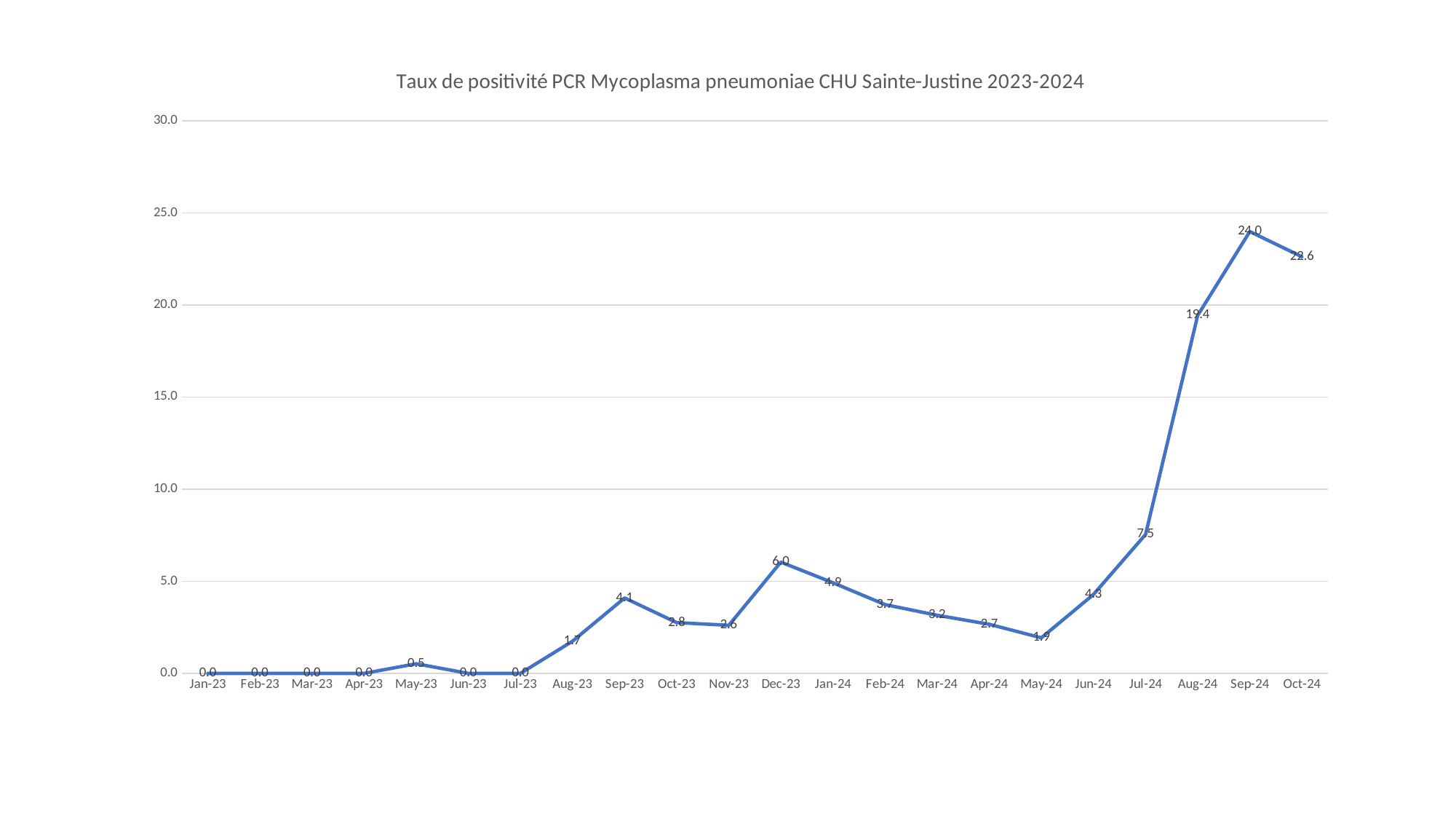
What is the difference between the values for Sep-24 and Aug-24? 4.6 Which is larger, the value for Dec-23 or the value for Sep-23? Dec-23 What is the value for Dec-23? 6.0 What is the difference between the values for Dec-23 and Nov-23? 3.4 Which month has the highest value? Sep-24 Is the value for Aug-24 greater or less than 15.0? greater What type of chart is shown on the slide? Line chart Do the values rise or fall from May-24 to Sep-24? Rise What is the value for Aug-24? 19.4 What is the title of the chart? Taux de positivité PCR Mycoplasma pneumoniae CHU Sainte-Justine 2023-2024 What is the value for Sep-24? 24.0 How many months (data points) are plotted on the x axis? 22